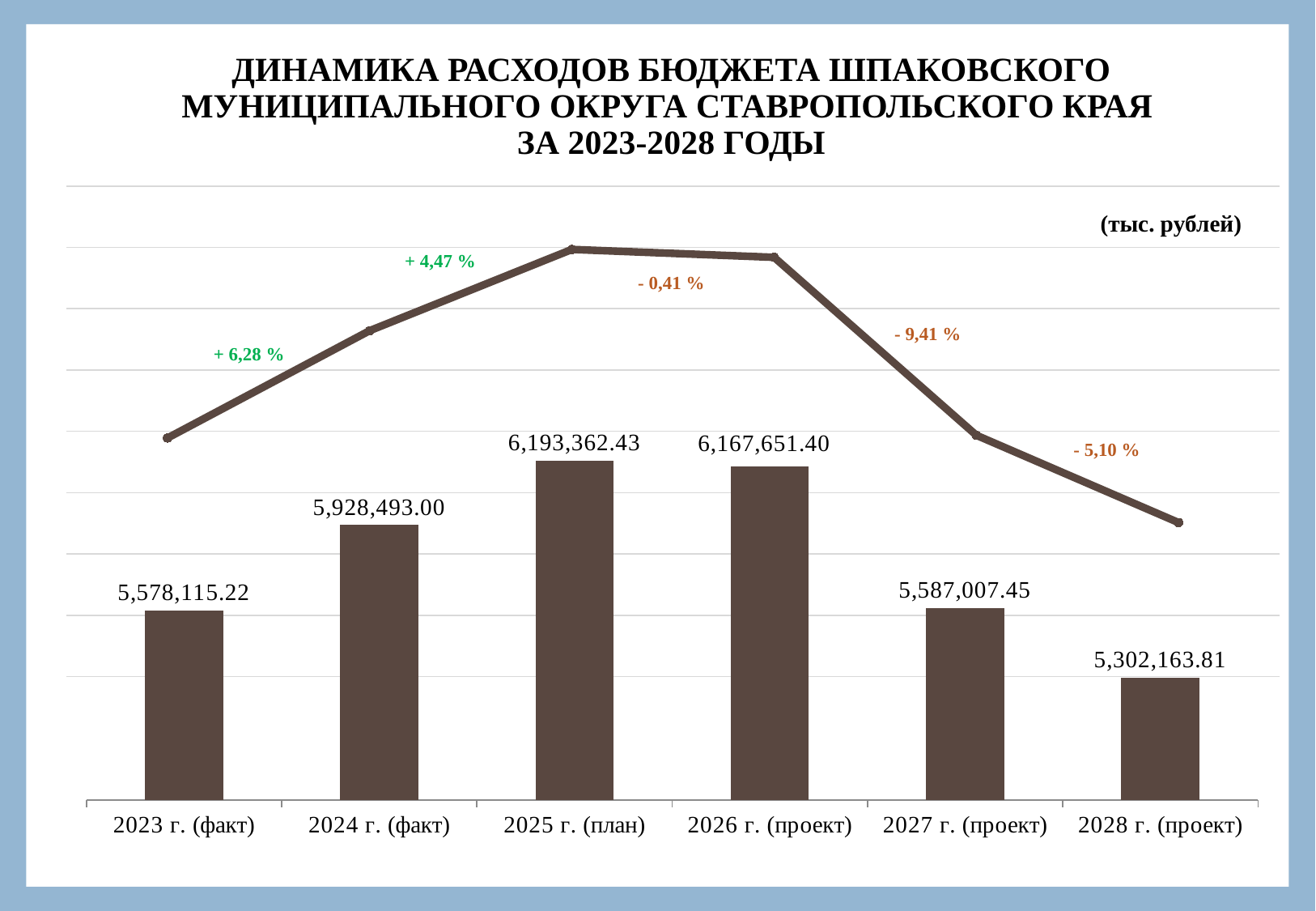
Which is larger, the value for 2024 г. (факт) or 2027 г. (проект)? 2024 г. (факт) What is the value for 2023 г. (факт)? 5,578,115.22 What is the difference between the values for 2024 г. (факт) and 2023 г. (факт)? 350,377.78 What is the value for 2028 г. (проект)? 5,302,163.81 How many years are shown on the x axis? 6 Which year has the lowest value? 2028 г. (проект) What is the value for 2027 г. (проект)? 5,587,007.45 Which year has the highest value? 2025 г. (план) What unit is stated for the values on the chart? тыс. рублей What is the value for 2025 г. (план)? 6,193,362.43 What percentage change is labelled between 2026 г. (проект) and 2027 г. (проект)? - 9,41 % What is the difference between the values for 2025 г. (план) and 2026 г. (проект)? 25,711.03